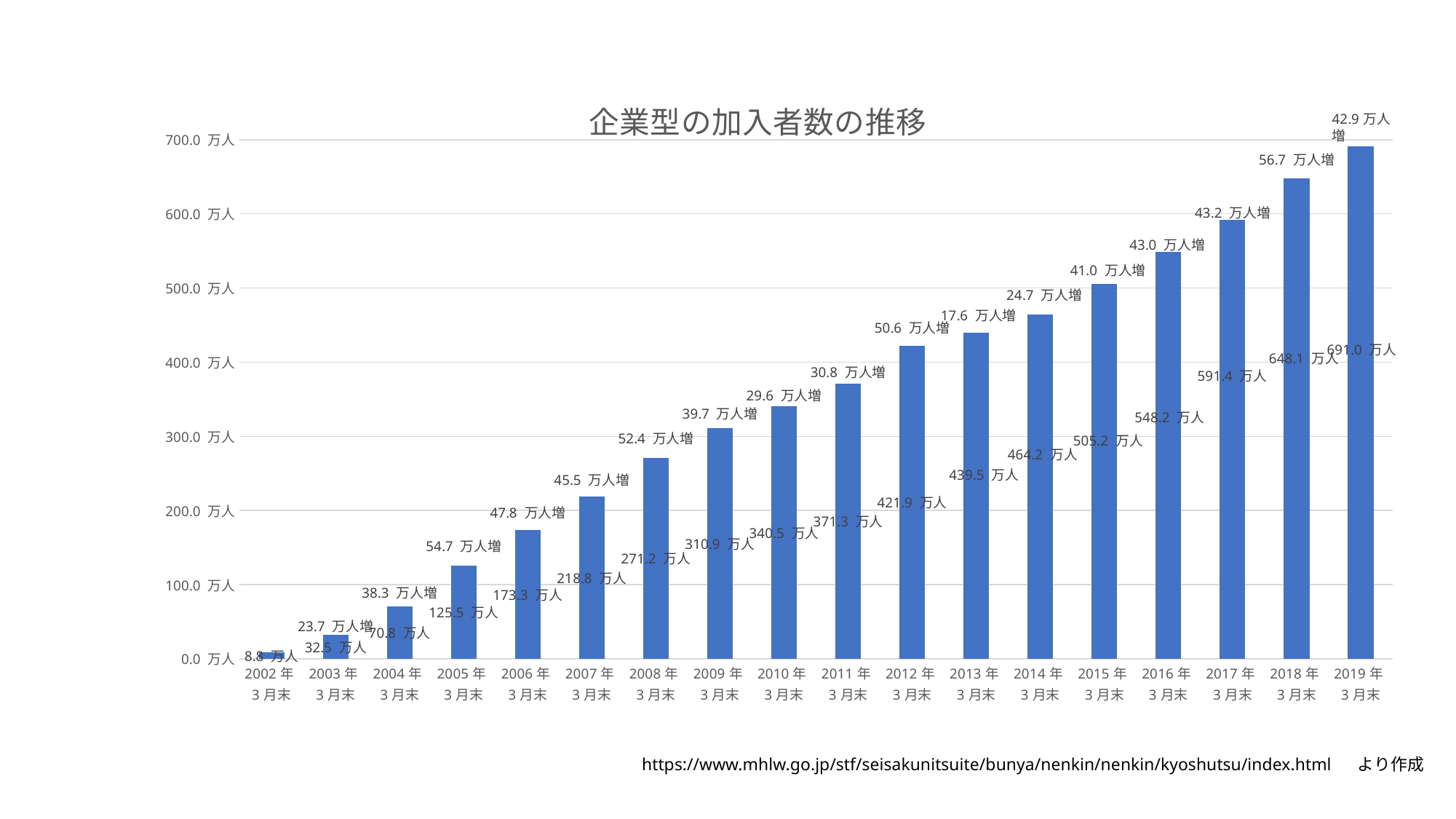
What is the difference between the values for 2019年3月末 and 2018年3月末? 42.9 万人 What is the value for 2019年3月末? 691.0 万人 Which year has the lowest value? 2002年3月末 Do the values rise or fall from 2002年3月末 to 2019年3月末? rise How many years are shown on the x axis? 18 What is the difference between the values for 2013年3月末 and 2012年3月末? 17.6 万人 What kind of chart is this? bar chart What is the value for 2010年3月末? 340.5 万人 Is the value for 2015年3月末 greater or less than 500.0 万人? greater Which is larger, the value for 2008年3月末 or 2009年3月末? 2009年3月末 What is the value for 2002年3月末? 8.8 万人 Which year has the highest value? 2019年3月末